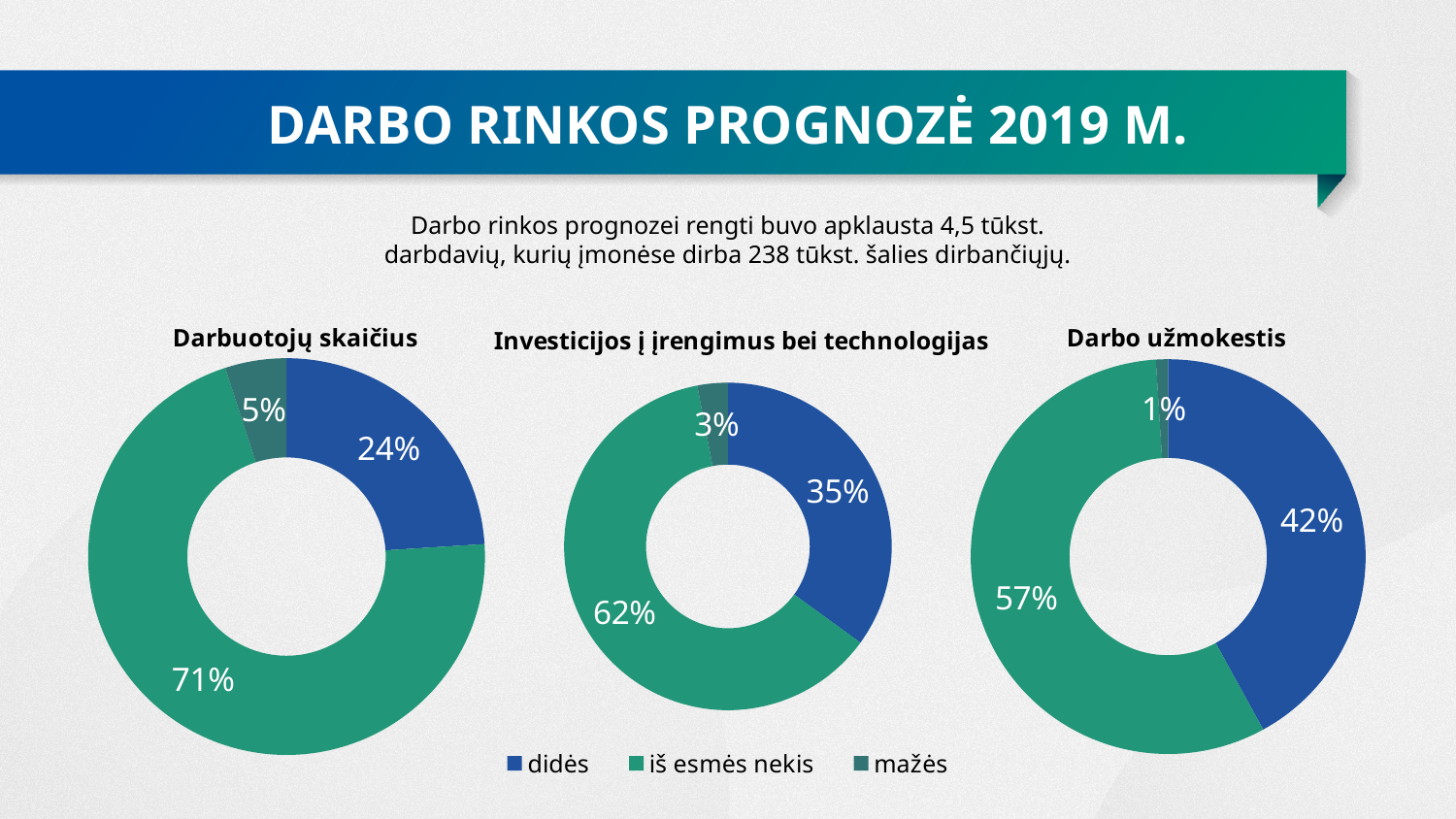
In the 'Darbo užmokestis' chart, what share is labelled for 'didės'? 42% How many entries does the legend list? 3 In the 'Darbuotojų skaičius' chart, what share is labelled for 'iš esmės nekis'? 71% In the 'Darbo užmokestis' chart, what is the difference between the 'iš esmės nekis' share and the 'didės' share? 15% In the 'Investicijos į įrengimus bei technologijas' chart, which is larger: the share for 'didės' or the share for 'iš esmės nekis'? iš esmės nekis In the 'Investicijos į įrengimus bei technologijas' chart, what share is labelled for 'mažės'? 3% In the 'Darbuotojų skaičius' chart, what share is labelled for 'didės'? 24% What kind of chart is the 'Darbuotojų skaičius' chart? Doughnut chart How many charts are shown on the slide? 3 Which colour represents 'didės' in the legend? Blue In the 'Investicijos į įrengimus bei technologijas' chart, which category has the smallest share? mažės In the 'Darbo užmokestis' chart, which category has the largest share? iš esmės nekis